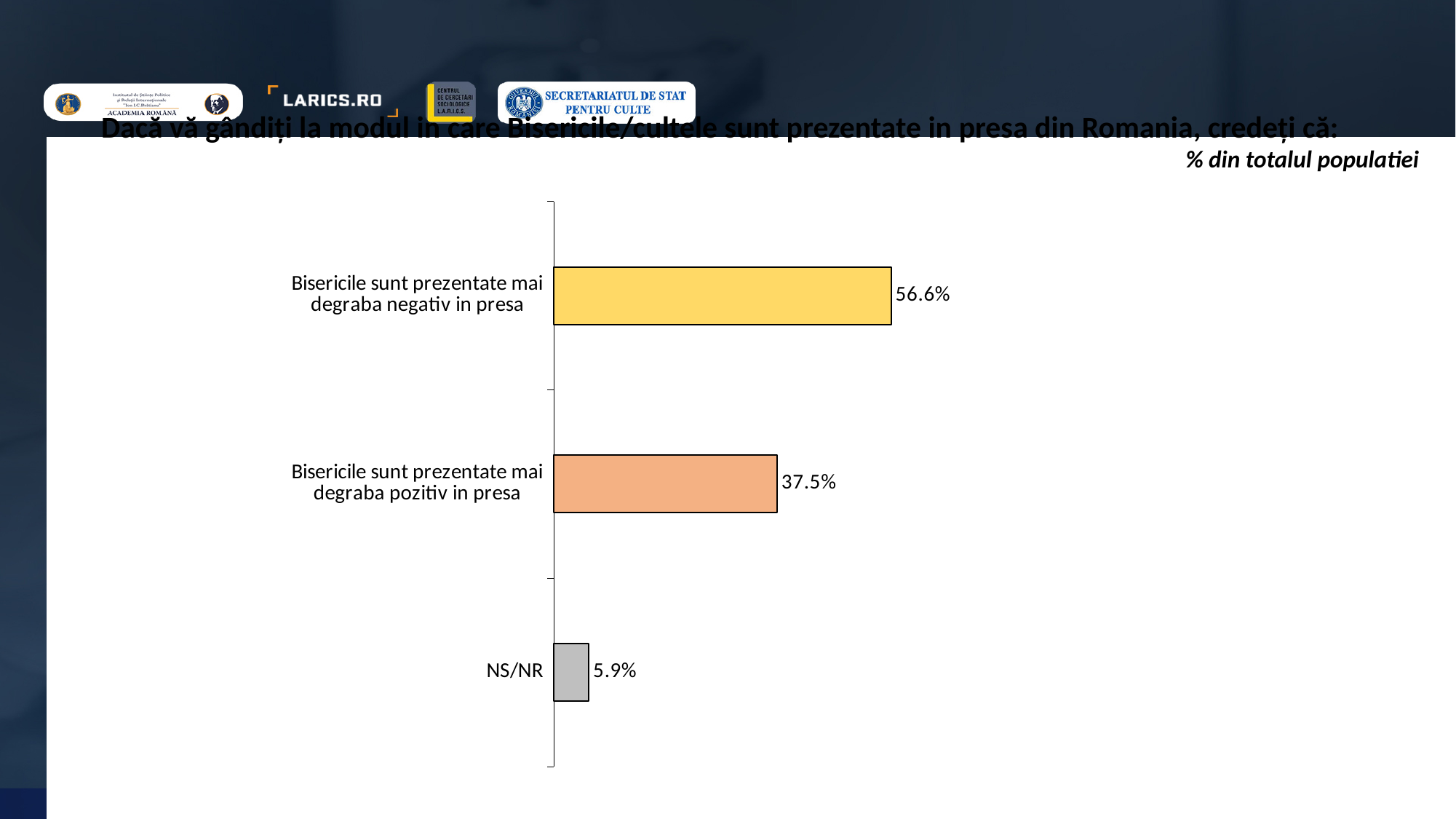
What type of chart is shown on the slide? Bar chart What is the difference between the "pozitiv" category and NS/NR? 31.6% How many categories are shown in the chart? 3 Which category has the lowest value? NS/NR What is the value shown for NS/NR? 5.9% What percentage of respondents say churches are presented rather negatively in the press ("Bisericile sunt prezentate mai degraba negativ in presa")? 56.6% What is the total of the three values shown in the chart? 100% What percentage of respondents say churches are presented rather positively in the press ("Bisericile sunt prezentate mai degraba pozitiv in presa")? 37.5% What unit note appears in italics above the chart on the right? % din totalul populatiei Which is larger: the value for "mai degraba negativ" or for "mai degraba pozitiv"? mai degraba negativ What is the difference between the "negativ" and "pozitiv" categories? 19.1% Which category has the highest value? Bisericile sunt prezentate mai degraba negativ in presa